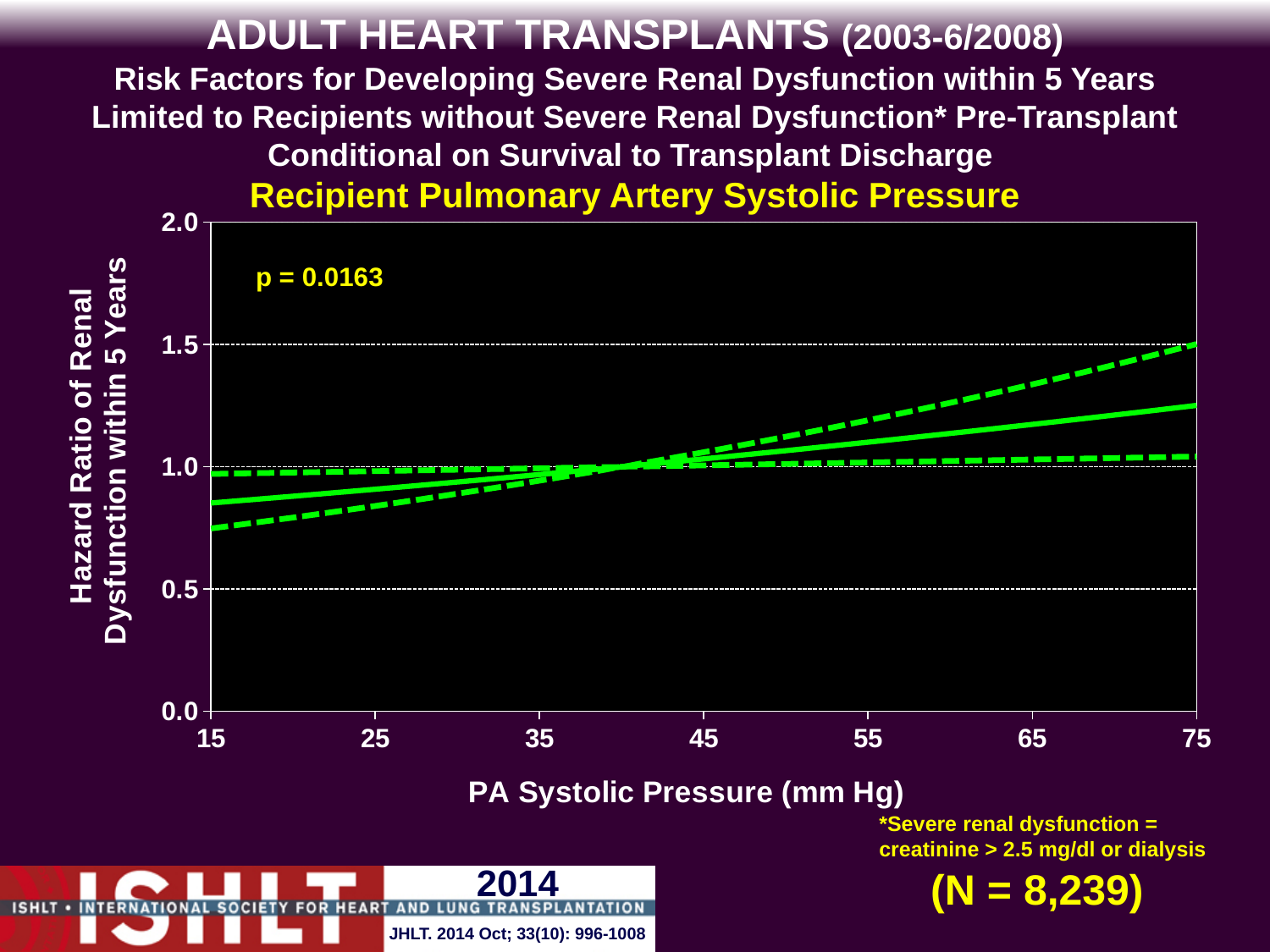
Is the upper dashed line at a PA systolic pressure of 75 mm Hg greater or less than 2.0? less What is the N shown on the slide? N = 8,239 How many lines are plotted on the chart? 3 Is the hazard ratio on the solid line larger at 75 mm Hg or at 15 mm Hg? 75 mm Hg Is the hazard ratio on the solid line at a PA systolic pressure of 75 mm Hg greater or less than 1.0? greater What is the label of the y axis? Hazard Ratio of Renal Dysfunction within 5 Years Does the solid line for hazard ratio rise or fall as PA systolic pressure increases from 15 to 75 mm Hg? rise What is the label of the x axis? PA Systolic Pressure (mm Hg) Is the hazard ratio on the solid line at a PA systolic pressure of 15 mm Hg greater or less than 1.0? less What kind of chart is shown on the slide? line chart What p-value is shown on the chart? p = 0.0163